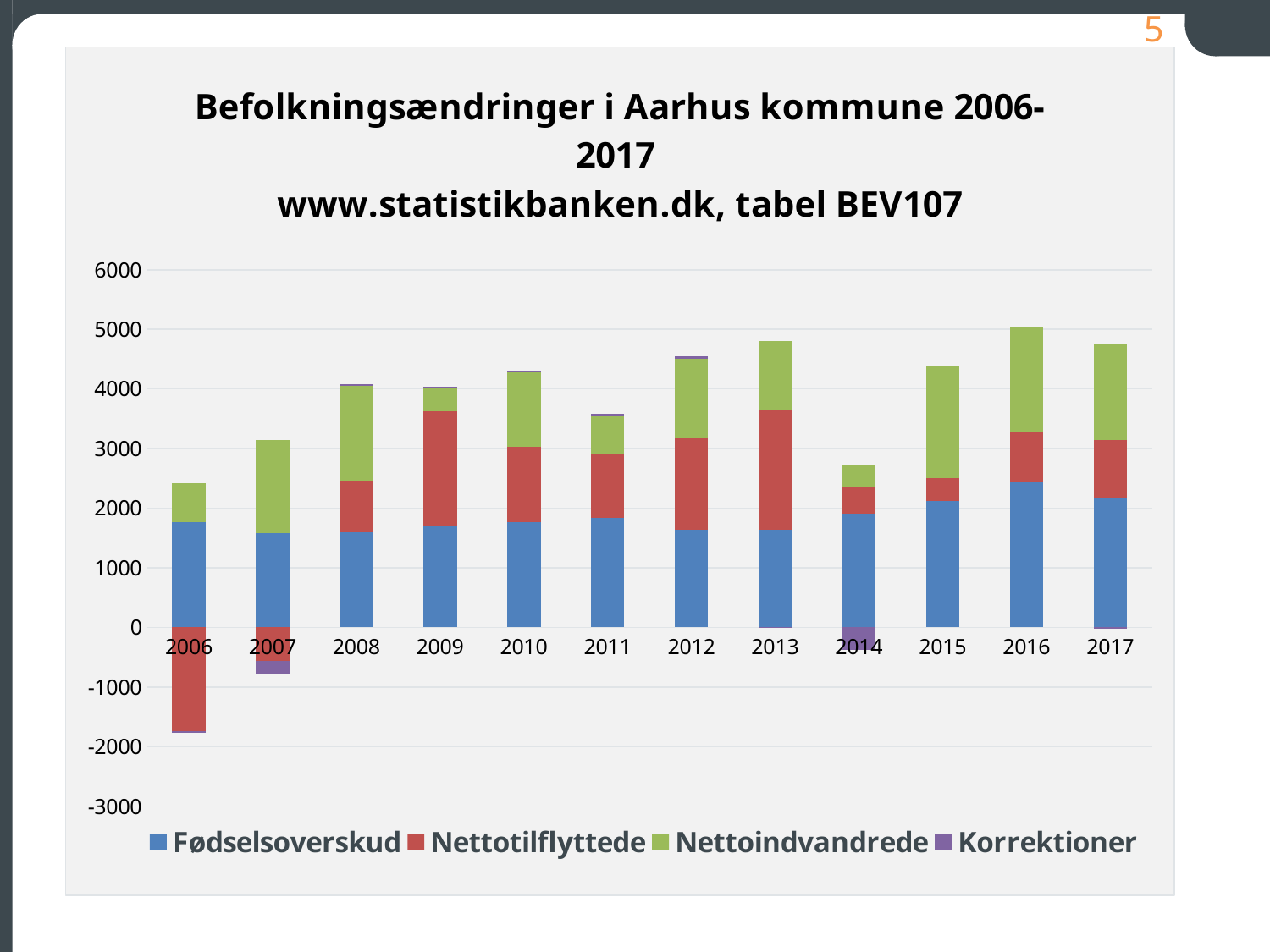
How many series does the legend list? 4 What kind of chart is shown on the slide? Stacked bar chart Is the top of the positive stacked bar for 2013 greater or less than 5000? less Which colour represents Korrektioner in the legend? Purple Is the Fødselsoverskud value for 2016 greater or less than 2000? greater Which is larger, the Nettotilflyttede value for 2009 or for 2015? 2009 Is the top of the positive stacked bar for 2014 greater or less than 3000? less How many years are shown on the x axis of the chart? 12 Does the height of the positive stacked bar rise or fall from 2014 to 2016? rise Which is larger, the Fødselsoverskud value for 2016 or for 2006? 2016